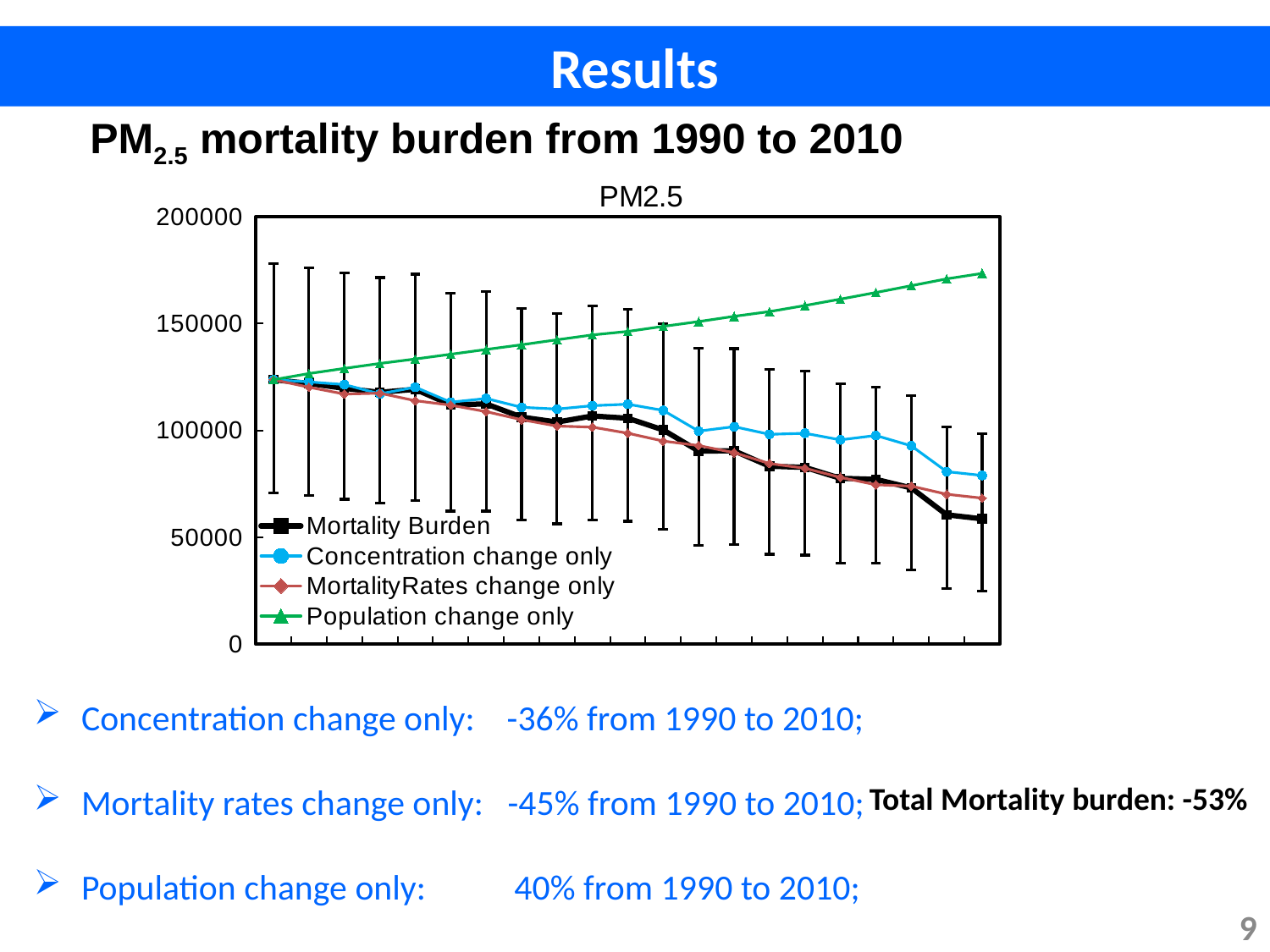
Does the Mortality Burden series rise or fall along the x axis? fall Is the final value of the Population change only series greater or less than 150000? greater At the right end of the chart, which is larger: the Concentration change only value or the Mortality Burden value? Concentration change only What kind of chart is shown on the slide? line chart Does the Concentration change only series rise or fall along the x axis? fall Which series has the lowest value at the right end of the chart? Mortality Burden Is the final value of the Concentration change only series greater or less than 100000? less Does the Population change only series rise or fall along the x axis? rise Which series is drawn in green on the chart? Population change only What is the title of the chart? PM2.5 How many series does the chart legend list? 4 Which series has the highest value at the right end of the chart? Population change only